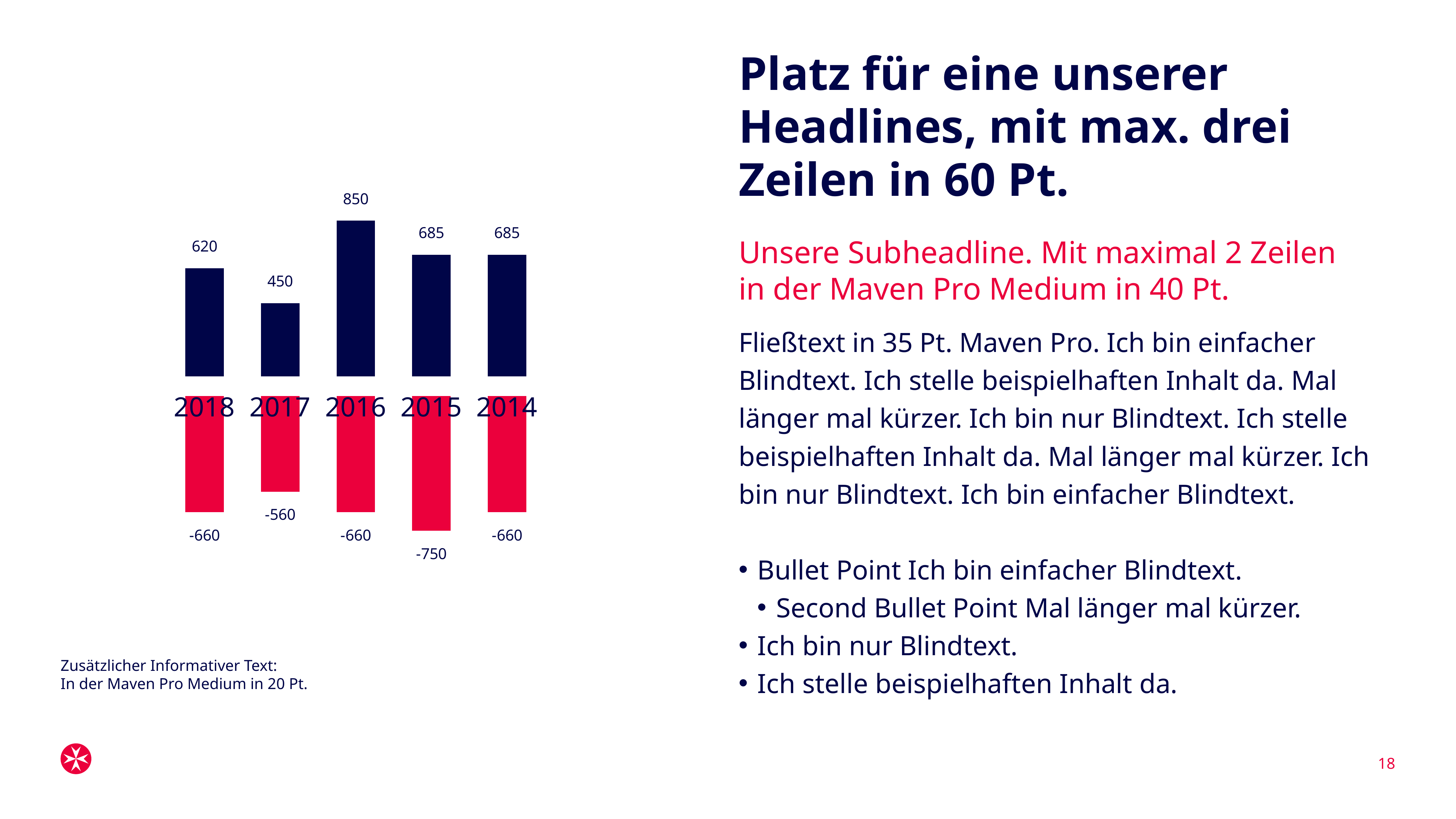
What is the value of the red bar for 2017? -560 Which year has the lowest red bar value? 2015 What is the value of the dark blue bar for 2018? 620 Which is larger, the dark blue bar for 2018 or for 2015? 2015 What colour are the bars with negative values? Red What kind of chart is shown on the slide? Bar chart What is the difference between the dark blue bars for 2016 and 2017? 400 What is the value of the dark blue bar for 2017? 450 What is the value of the red bar for 2015? -750 How many years are shown on the x axis? 5 Which year has the lowest dark blue bar? 2017 Which year has the highest dark blue bar? 2016